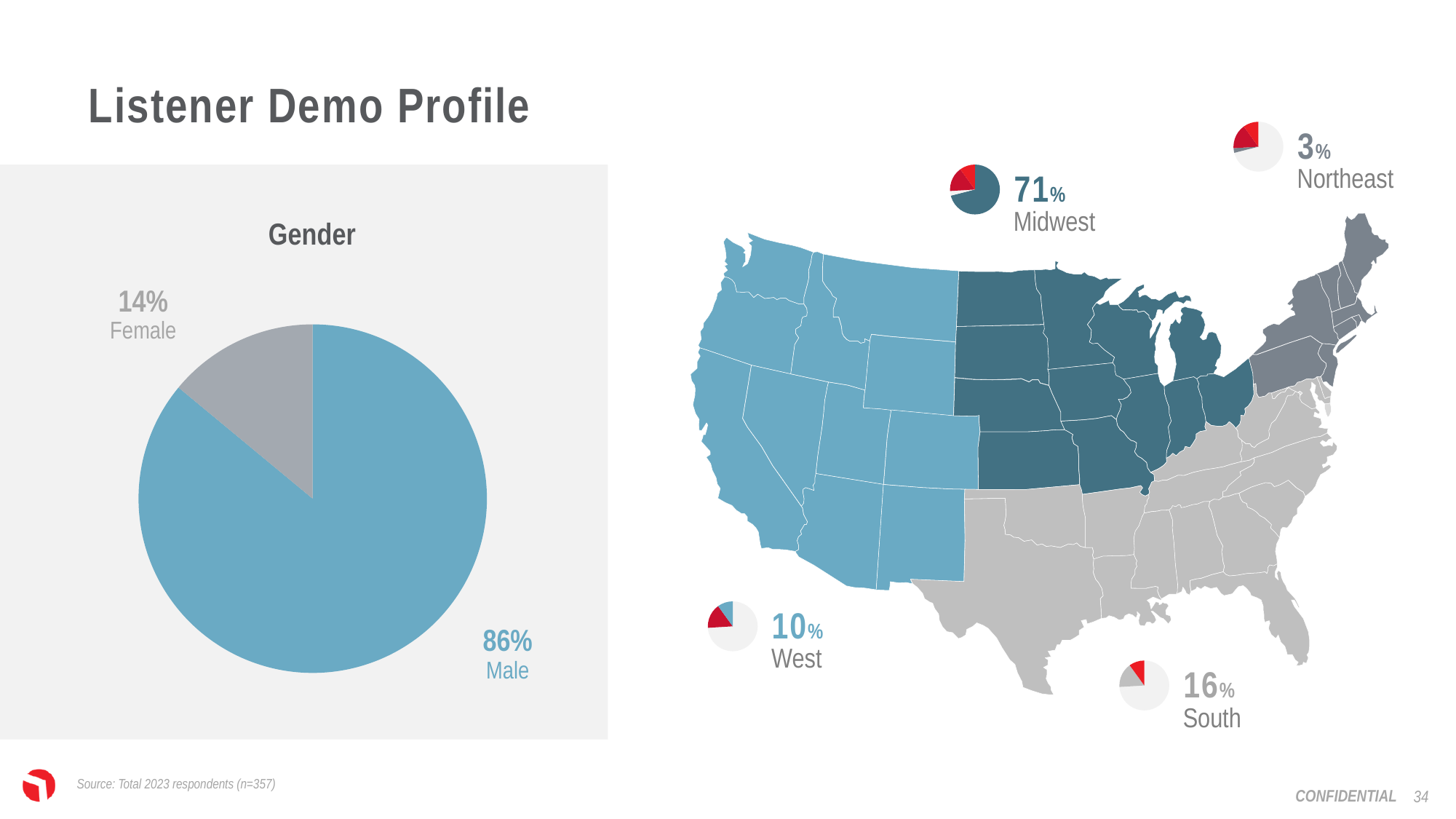
In the Gender chart, what percentage of listeners are Male? 86% How many slices does the Gender pie chart have? 2 In the Gender chart, which slice is larger, Male or Female? Male What is the title of the pie chart on the left of the slide? Gender What kind of chart is the Gender chart? Pie chart In the Gender chart, which category has the smallest share? Female On the regional map chart, what percentage of listeners are in the Midwest? 71% In the Gender chart, what is the difference in percentage points between Male and Female? 72 In the Gender chart, what percentage of listeners are Female? 14% On the regional map chart, what is the difference in percentage points between the South and the West? 6 On the regional map chart, which region has the lowest percentage of listeners? Northeast In the Gender chart, which category has the largest share? Male